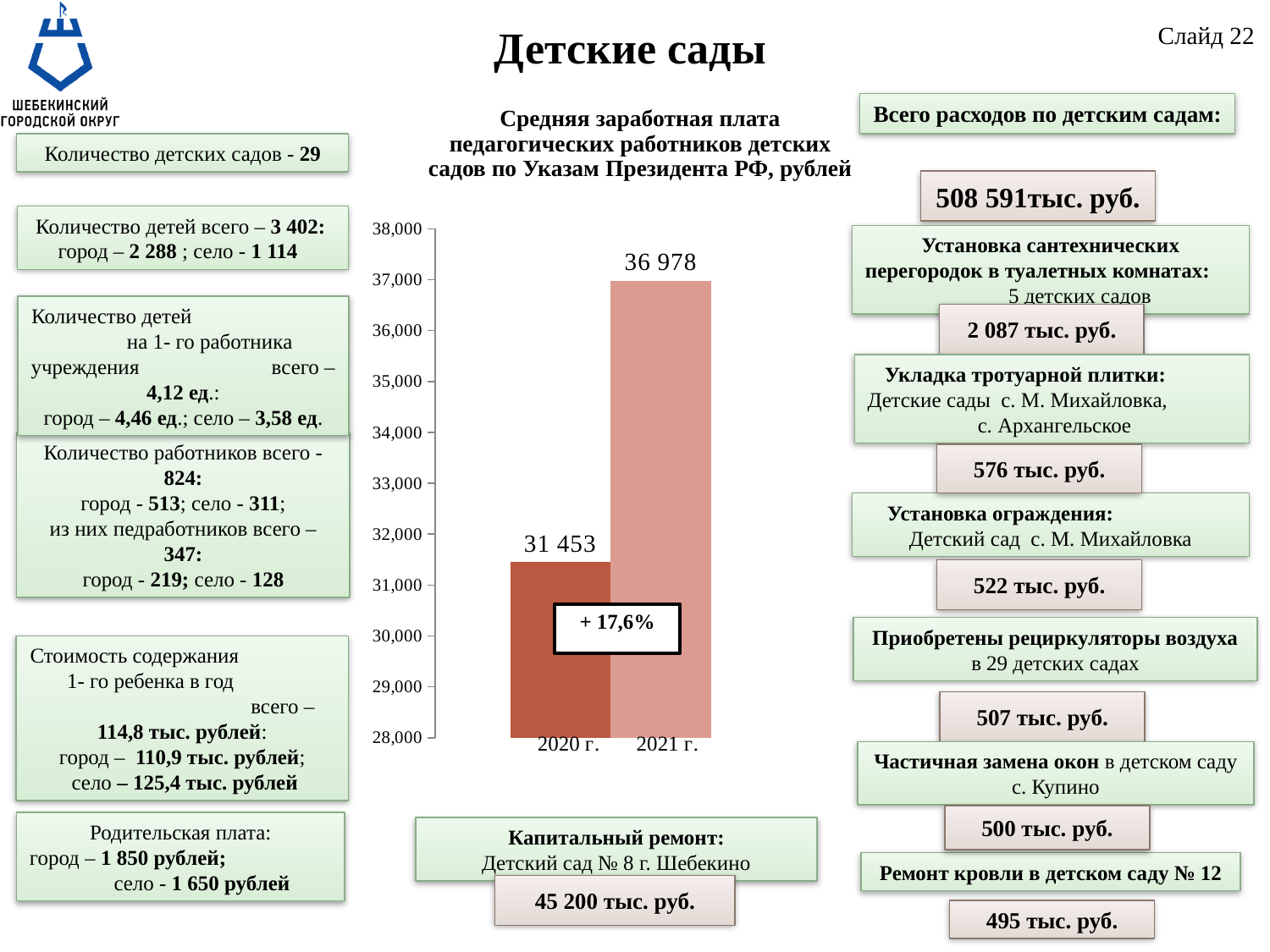
What is the average salary value shown for 2020 г. on the chart? 31 453 Do the values on the chart rise or fall from 2020 г. to 2021 г.? Rise What type of chart is used to show the average salary of pedagogical workers? Bar chart What percentage change is annotated on the chart between the two bars? + 17,6% How many bars (years) are plotted on the chart? 2 Which year has the higher bar on the chart, 2020 г. or 2021 г.? 2021 г. Is the value for 2020 г. greater or less than 32,000? less What is the average salary value shown for 2021 г. on the chart? 36 978 Is the value for 2021 г. greater or less than 36,000? greater By how much does the 2021 г. value exceed the 2020 г. value on the chart? 5 525 Which year has the lowest value on the chart? 2020 г. What is the lowest value shown on the chart's vertical axis? 28,000